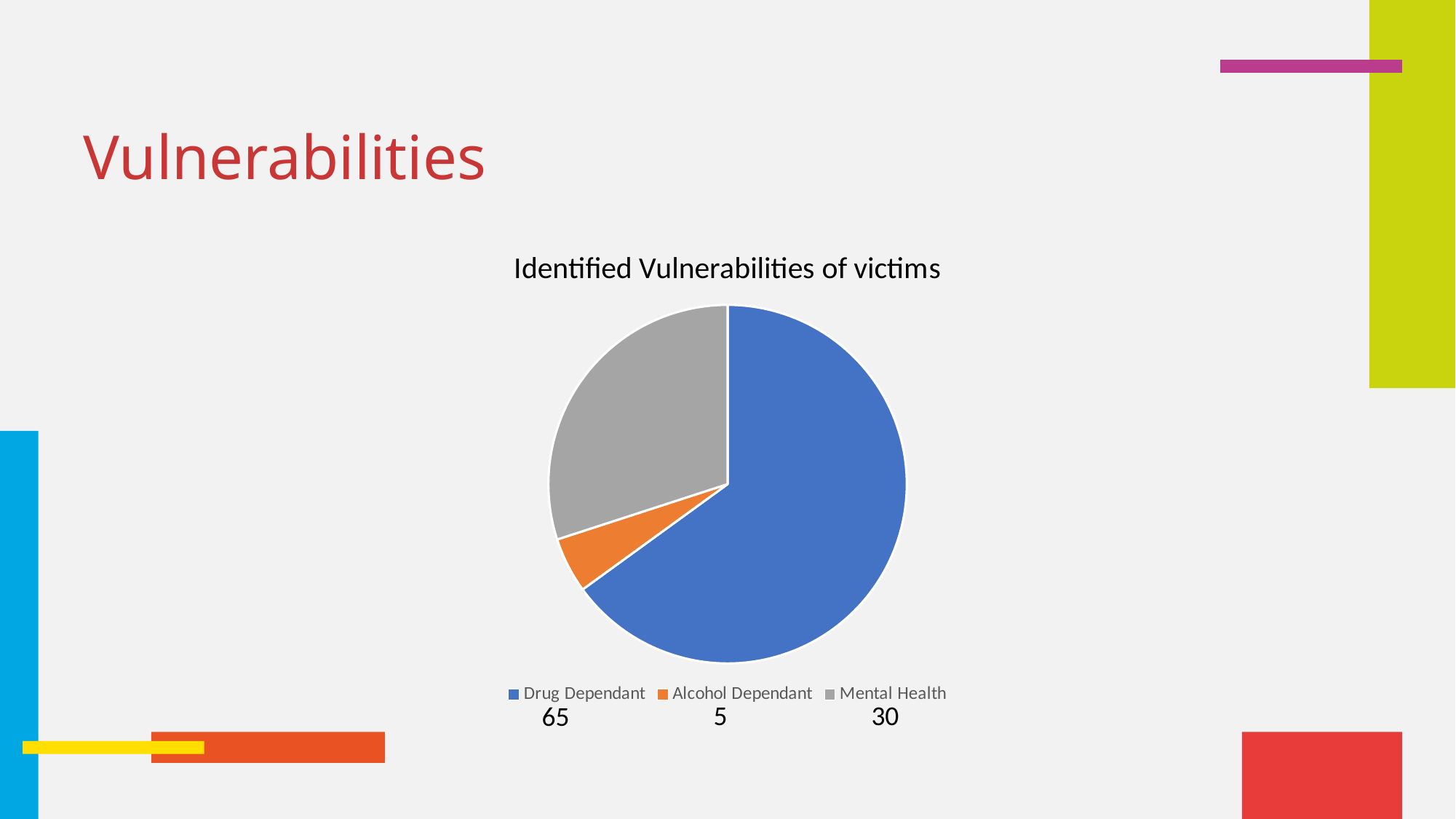
What is the value shown for Drug Dependant? 65 What is the difference between the values for Drug Dependant and Mental Health? 35 What kind of chart is shown on the slide? pie chart Which colour represents Mental Health in the pie chart? grey How many categories does the pie chart have? 3 What is the value shown for Mental Health? 30 What share of the pie does Drug Dependant represent? 65% Which category has the smallest slice of the pie? Alcohol Dependant What is the value shown for Alcohol Dependant? 5 Which is larger, the value for Mental Health or the value for Alcohol Dependant? Mental Health Which category has the largest slice of the pie? Drug Dependant What is the title of the chart? Identified Vulnerabilities of victims